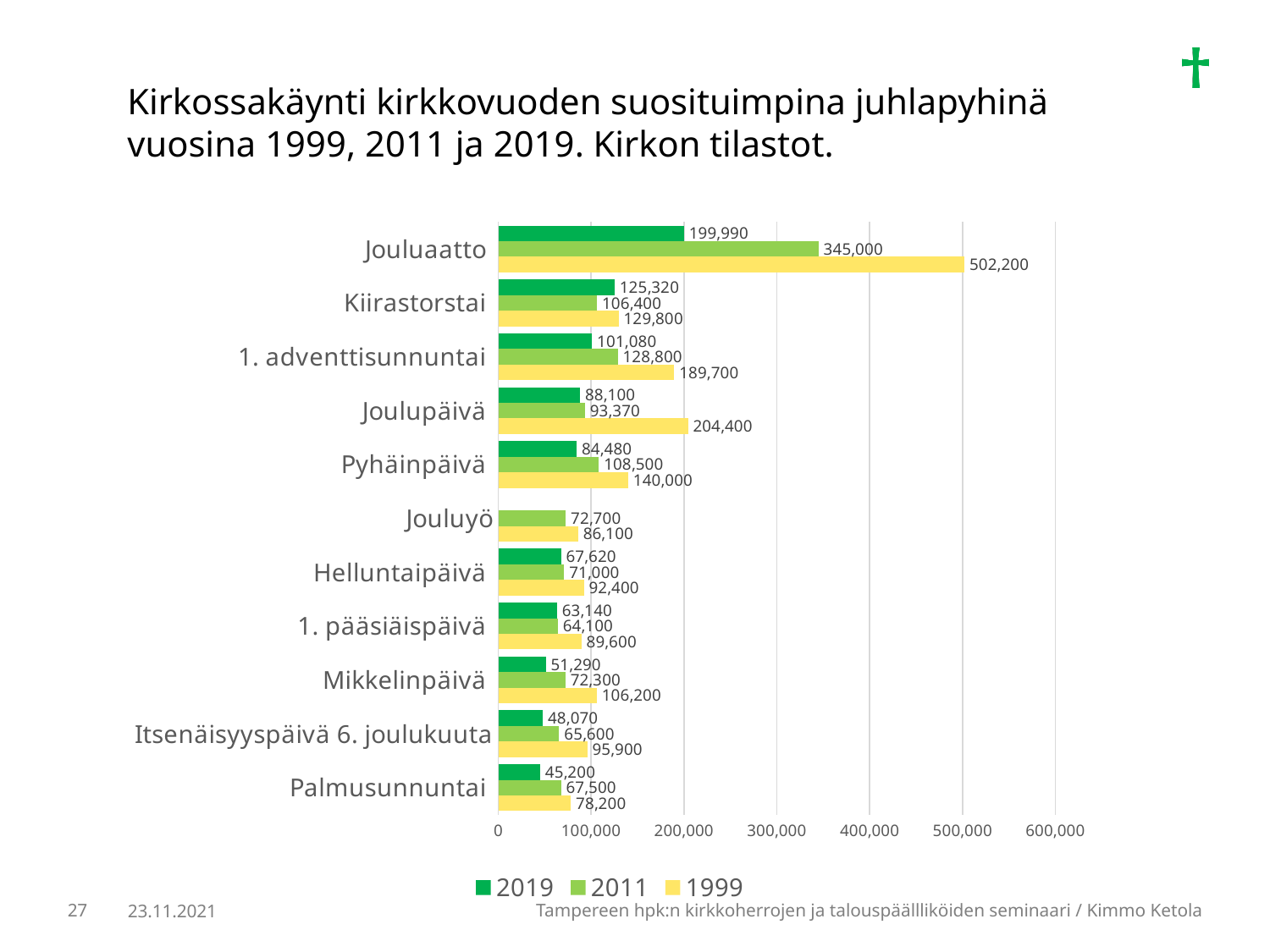
How many series does the legend list? 3 What was the church attendance on Joulupäivä in 2011? 93,370 Which was larger on Kiirastorstai: the 2019 attendance or the 2011 attendance? 2019 Which years are listed in the chart legend? 2019, 2011 and 1999 What was the church attendance on Jouluaatto in 1999? 502,200 What is the difference between the 1999 and 2019 attendance on Jouluaatto? 302,210 Which holiday had the lowest attendance in 1999? Palmusunnuntai Which holiday had the highest attendance in 2019? Jouluaatto What kind of chart is shown on the slide? Bar chart What was the church attendance on Palmusunnuntai in 2019? 45,200 How many holidays are listed on the chart? 11 Is the 1999 attendance on Joulupäivä greater or less than 200,000? greater